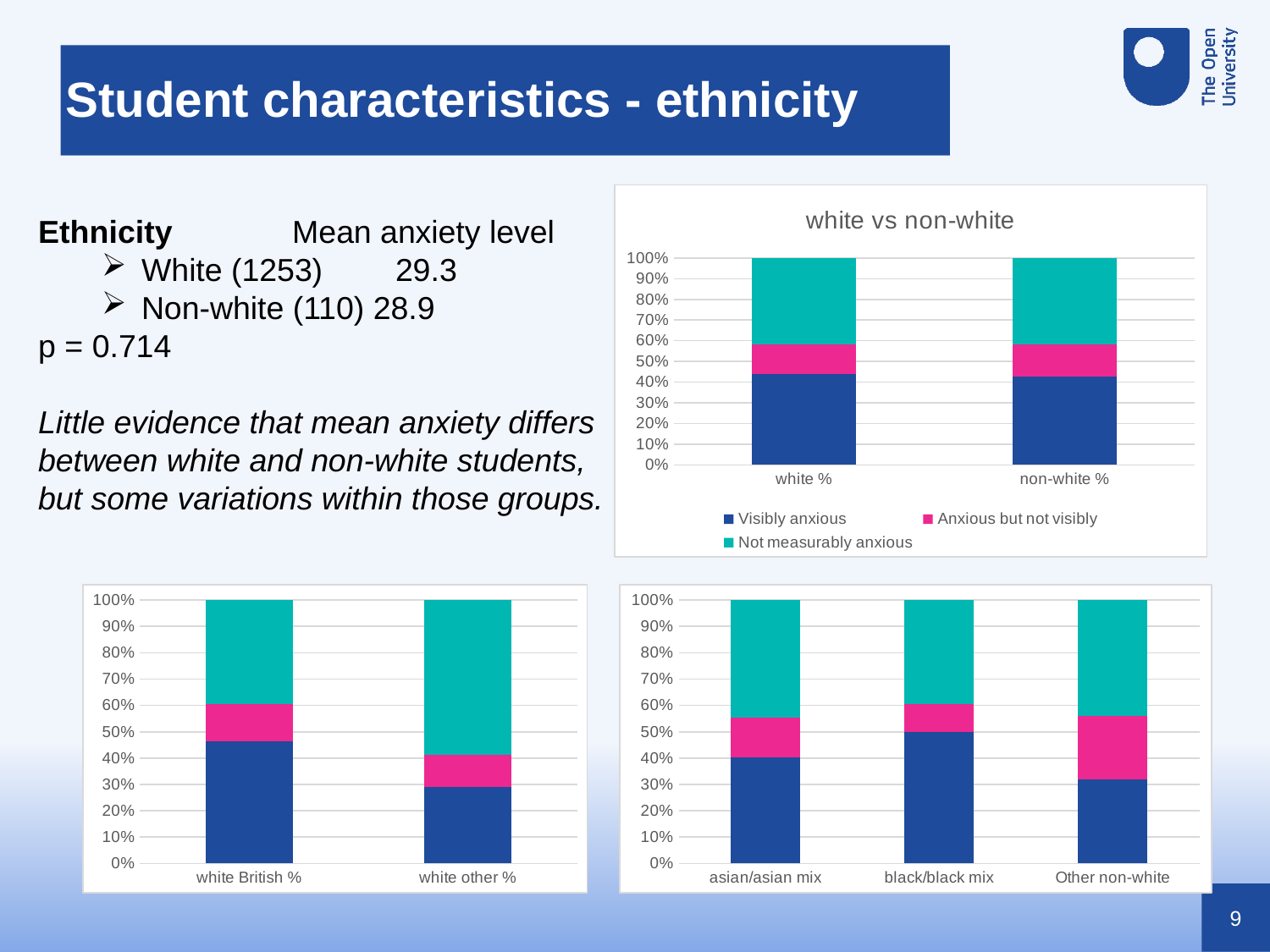
In the bottom-left chart, is the 'Visibly anxious' (dark blue) value for 'white other %' greater or less than 40%? less How many series does the legend of the 'white vs non-white' chart list? 3 In the bottom-right chart, is the 'Visibly anxious' (dark blue) value for 'Other non-white' greater or less than 40%? less How many categories are shown on the x axis of the bottom-left chart? 2 In the bottom-right chart, which category has the highest 'Visibly anxious' (dark blue) value? black/black mix What kind of chart is the 'white vs non-white' chart? stacked bar chart In the bottom-left chart, which category has the larger 'Visibly anxious' (dark blue) segment, 'white British %' or 'white other %'? white British % In the 'white vs non-white' chart, what is the total height of the stacked bar for 'non-white %'? 100% How many categories are shown on the x axis of the 'white vs non-white' chart? 2 How many categories are shown on the x axis of the bottom-right chart? 3 In the 'white vs non-white' chart, what are the three legend entries? Visibly anxious, Anxious but not visibly, Not measurably anxious In the 'white vs non-white' chart, is the 'Visibly anxious' value for 'white %' greater or less than 50%? less